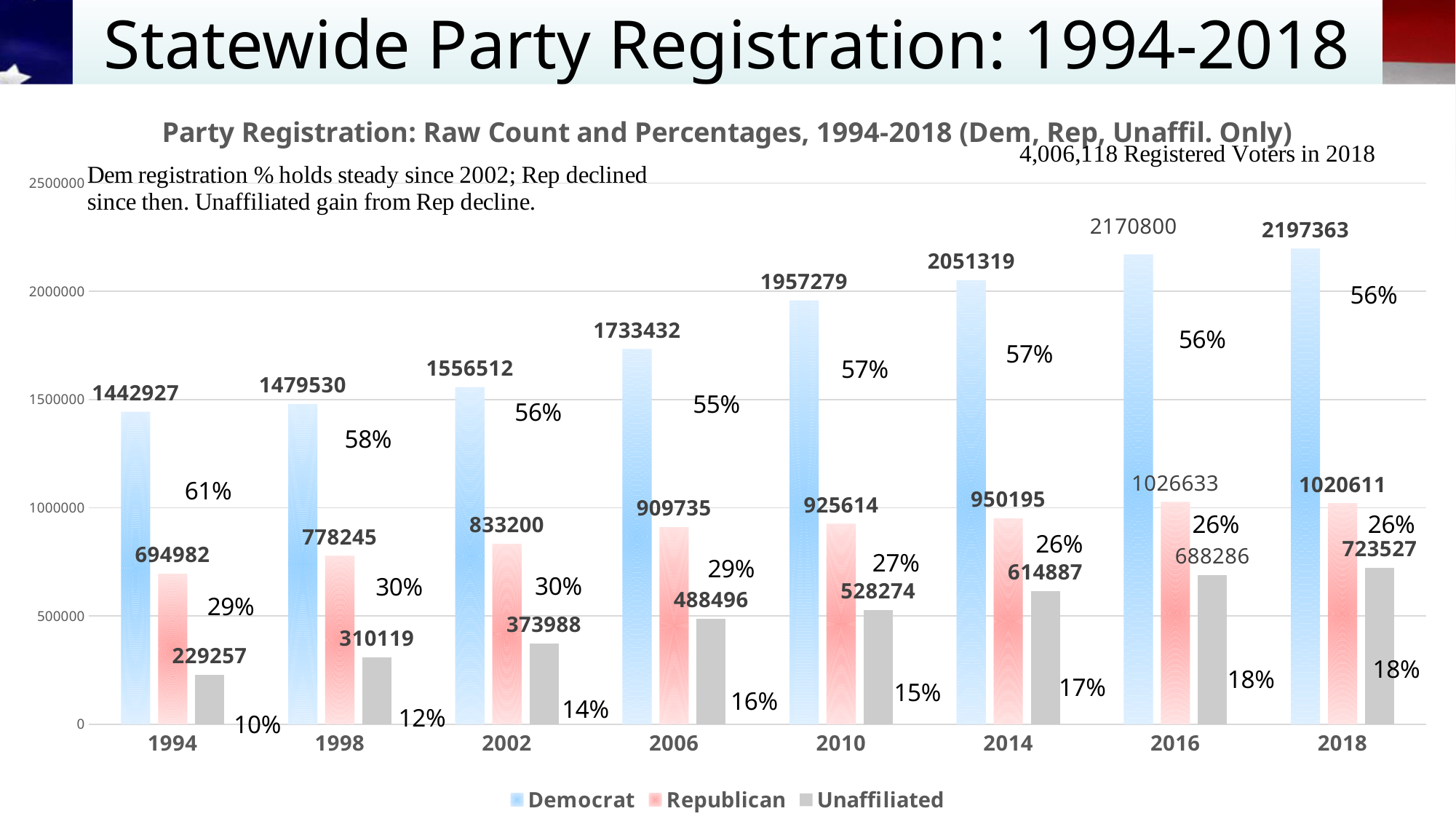
Does the Unaffiliated registration count rise or fall from 1994 to 2018? rise What is the Republican registration count for 2006? 909735 What is the difference between the Democrat and Republican counts in 2010? 1031665 How many years are shown on the x axis? 8 Which year has the highest Democrat registration count? 2018 Which is larger in 2016: the Republican count or the Unaffiliated count? Republican What is the Unaffiliated registration count for 1994? 229257 Is the Republican value for 2014 greater or less than 1000000? less How many series does the legend list? 3 Which year has the lowest Unaffiliated registration count? 1994 What kind of chart is shown? bar chart What is the Democrat registration count for 2018? 2197363